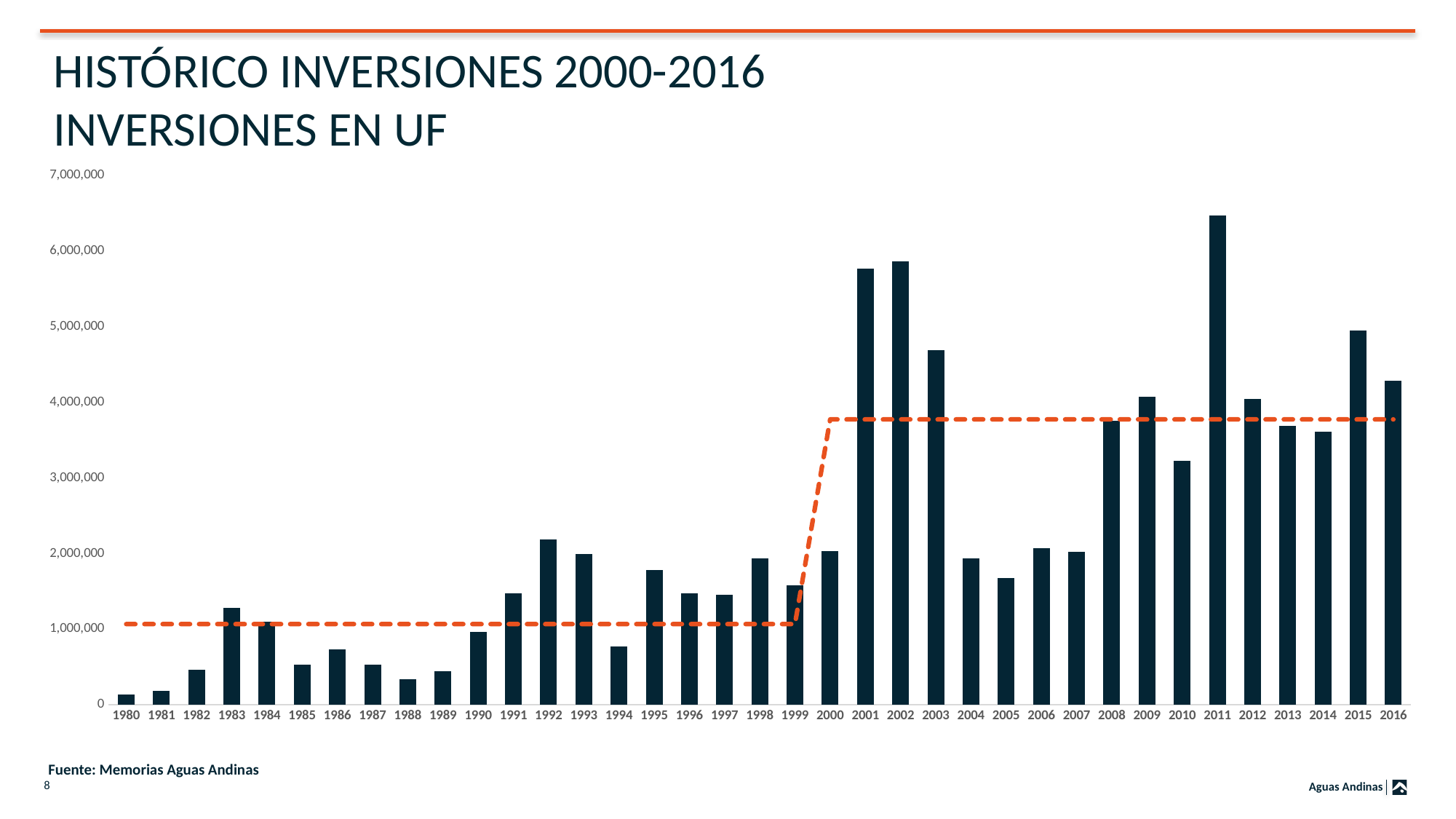
Is the value for 2001 greater or less than 6,000,000? less How many years (bars) are plotted on the x axis? 37 Which year has the lowest investment value in the chart? 1980 What source is cited below the chart? Fuente: Memorias Aguas Andinas Is the value for 2005 greater or less than 2,000,000? less Which year has the larger value, 2011 or 2002? 2011 Which year has the highest investment value in the chart? 2011 Is the value for 2011 greater or less than 6,000,000? greater Which year has the larger value, 2015 or 2016? 2015 What kind of chart is shown on the slide? Combination bar and line chart (bars with a dashed average line)